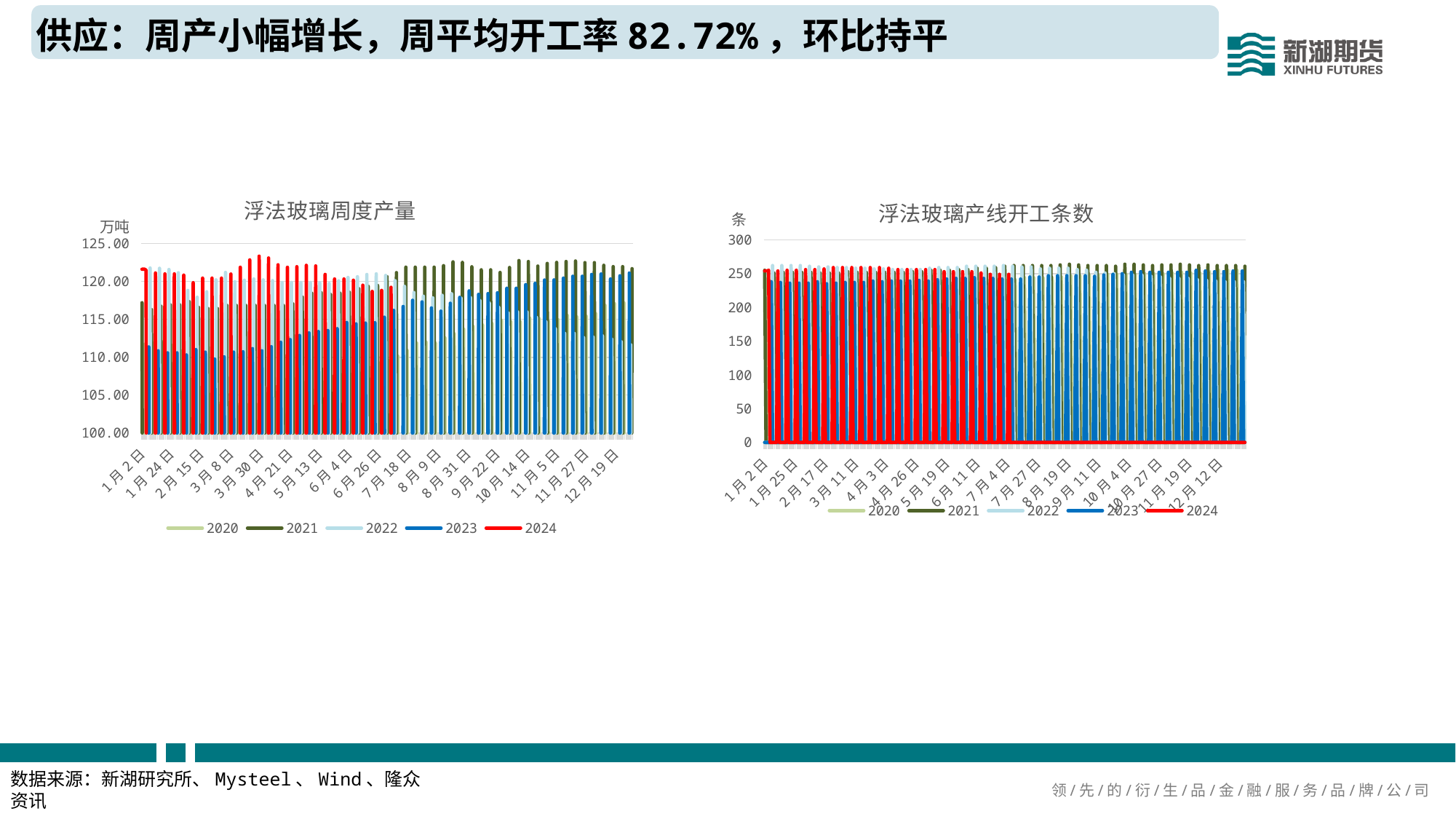
In the left chart 浮法玻璃周度产量, how many series does the legend list? 5 In the left chart 浮法玻璃周度产量, is the 2023 value at 1月24日 greater or less than 115.00? less In the right chart 浮法玻璃产线开工条数, is the 2024 value at 1月25日 greater or less than 200? greater In the left chart 浮法玻璃周度产量, which is larger at 1月24日: the 2024 value or the 2023 value? 2024 What is the unit shown on the y axis of the left chart 浮法玻璃周度产量? 万吨 In the left chart 浮法玻璃周度产量, is the 2024 value at 3月30日 greater or less than 120.00? greater In the right chart 浮法玻璃产线开工条数, how many series does the legend list? 5 What kind of chart is the left chart titled 浮法玻璃周度产量? line chart What kind of chart is the right chart titled 浮法玻璃产线开工条数? line chart What is the unit shown on the y axis of the right chart 浮法玻璃产线开工条数? 条